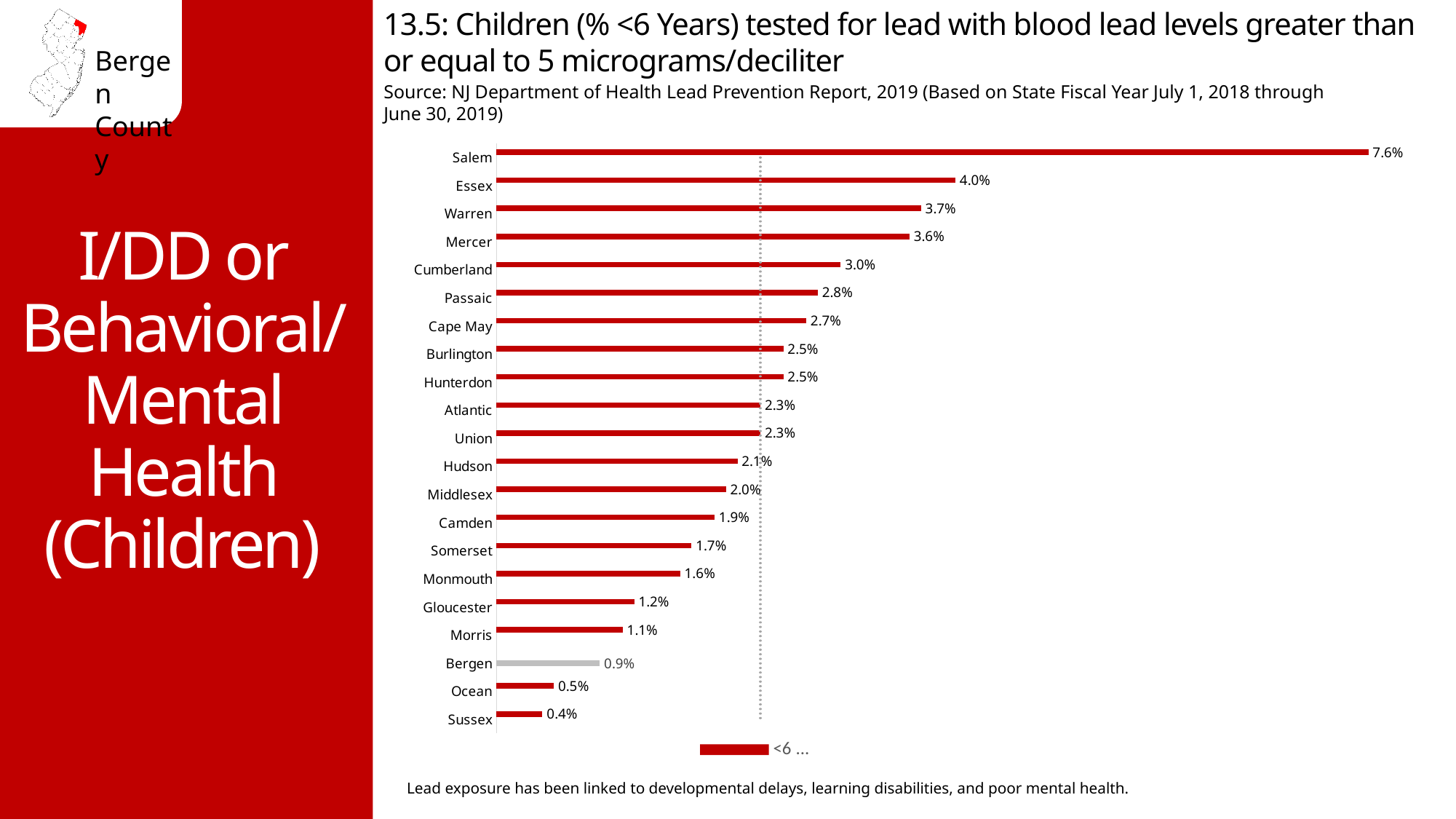
Which has a larger value, Morris or Gloucester? Gloucester Which county has the highest value? Salem Which has a larger value, Passaic or Camden? Passaic What is the value for Bergen? 0.9% What is the value for Cumberland? 3.0% What is the difference between the values for Bergen and Sussex? 0.5% Which county has the lowest value? Sussex How many counties are shown in the chart? 21 What is the value for Essex? 4.0% What is the difference between the values for Salem and Essex? 3.6% Which county's bar is shown in gray rather than red? Bergen What kind of chart is shown on the slide? Bar chart